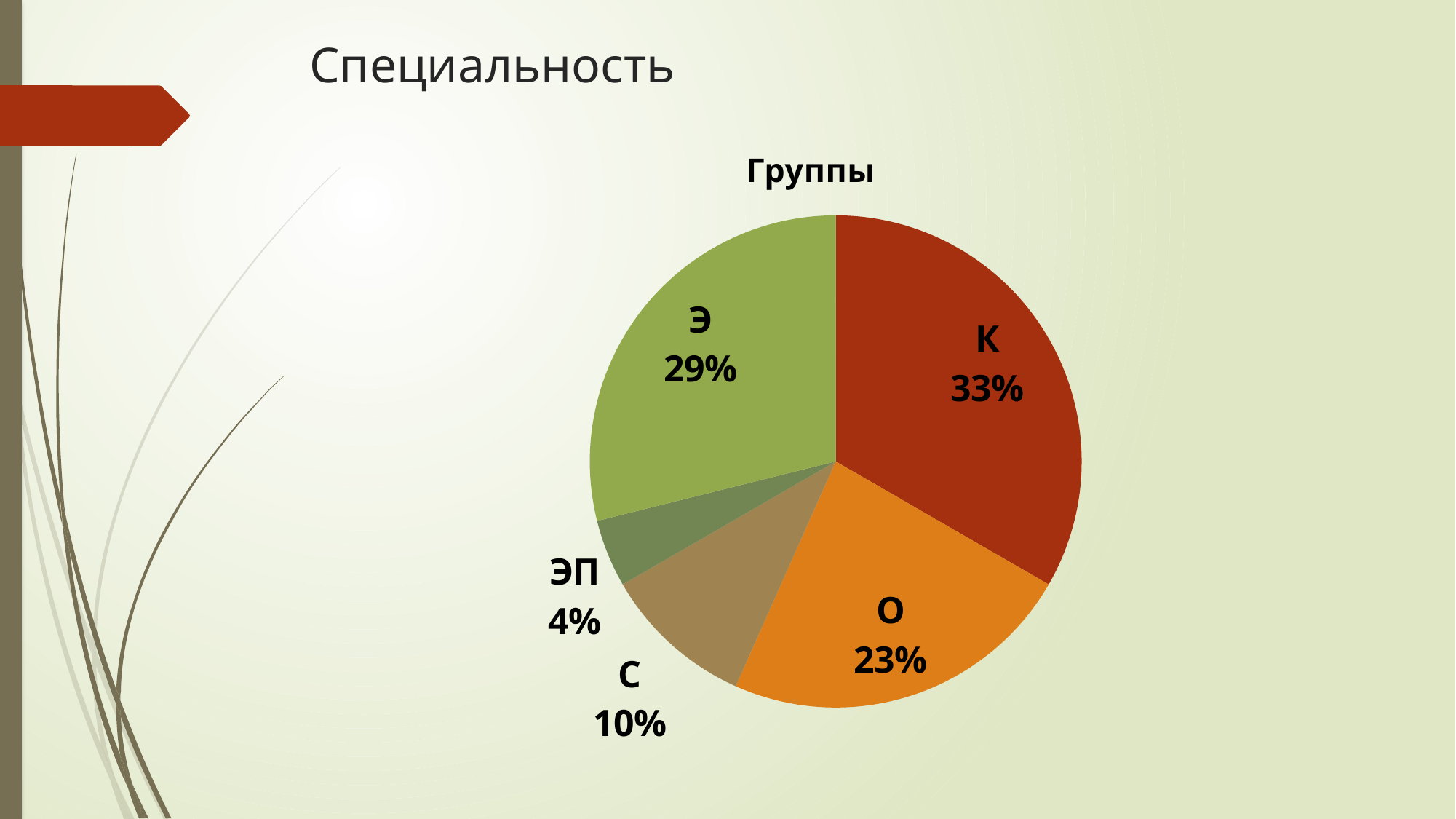
What share of the pie does the ЭП slice have? 4% What share of the pie does the К slice have? 33% Which slice is the smallest? ЭП What kind of chart is shown on the slide? pie chart What share of the pie does the О slice have? 23% What is the title of the chart? Группы Which is larger, the Э slice or the С slice? Э What share of the pie does the Э slice have? 29% What is the difference between the К and О slices? 10% Which slice is the largest? К What share of the pie does the С slice have? 10% How many slices does the pie chart have? 5